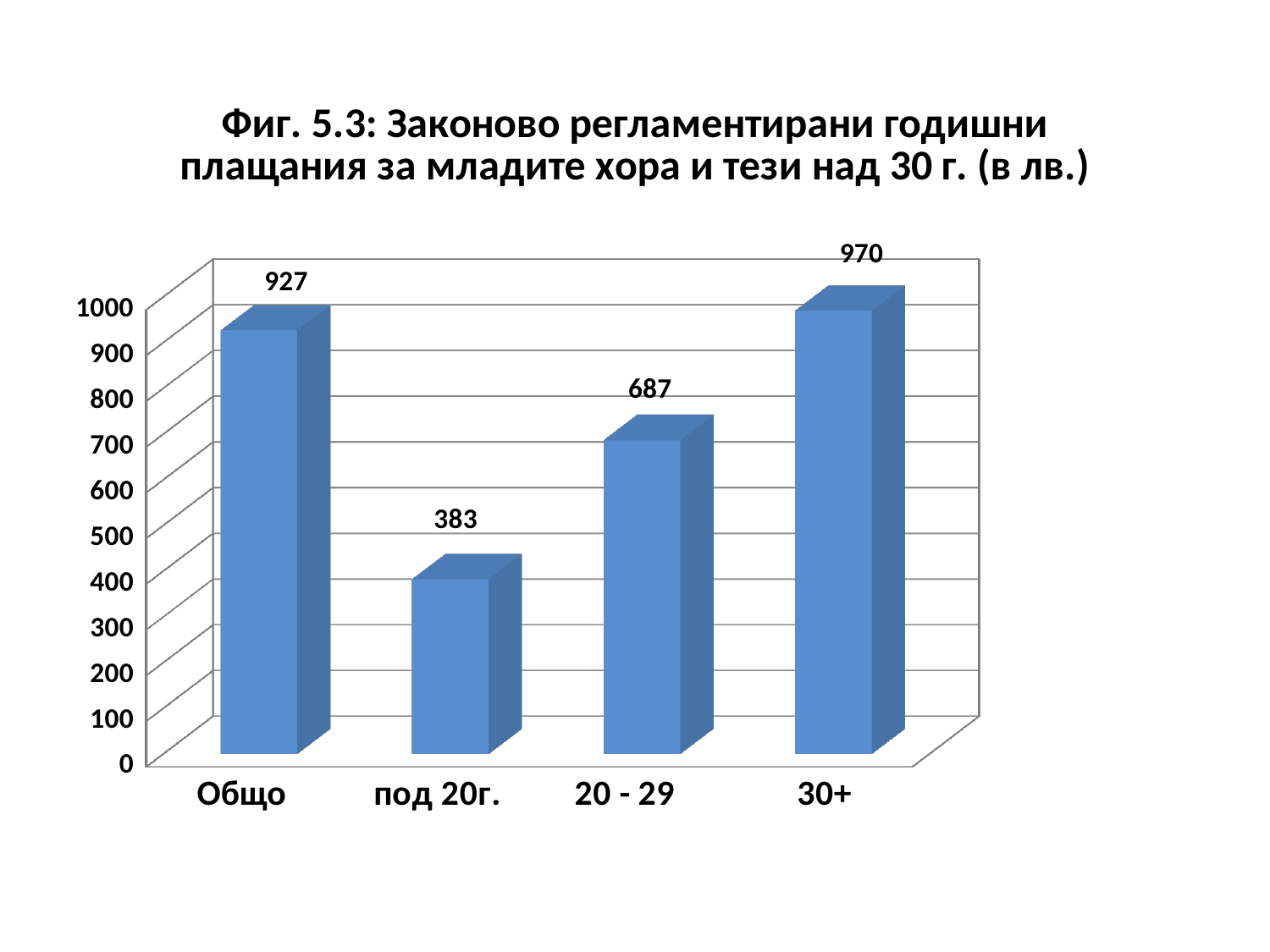
How many categories are shown on the x axis? 4 What is the difference between the values for "30+" and "под 20г."? 587 What is the title of the chart? Фиг. 5.3: Законово регламентирани годишни плащания за младите хора и тези над 30 г. (в лв.) Which category has the lowest value? под 20г. What is the difference between the values for "Общо" and "20 - 29"? 240 Which category has the highest value? 30+ What is the value for "30+"? 970 What is the value for "Общо"? 927 Which is larger, the value for "20 - 29" or the value for "под 20г."? 20 - 29 What kind of chart is shown on the slide? Bar chart What is the value for "под 20г."? 383 What is the value for "20 - 29"? 687